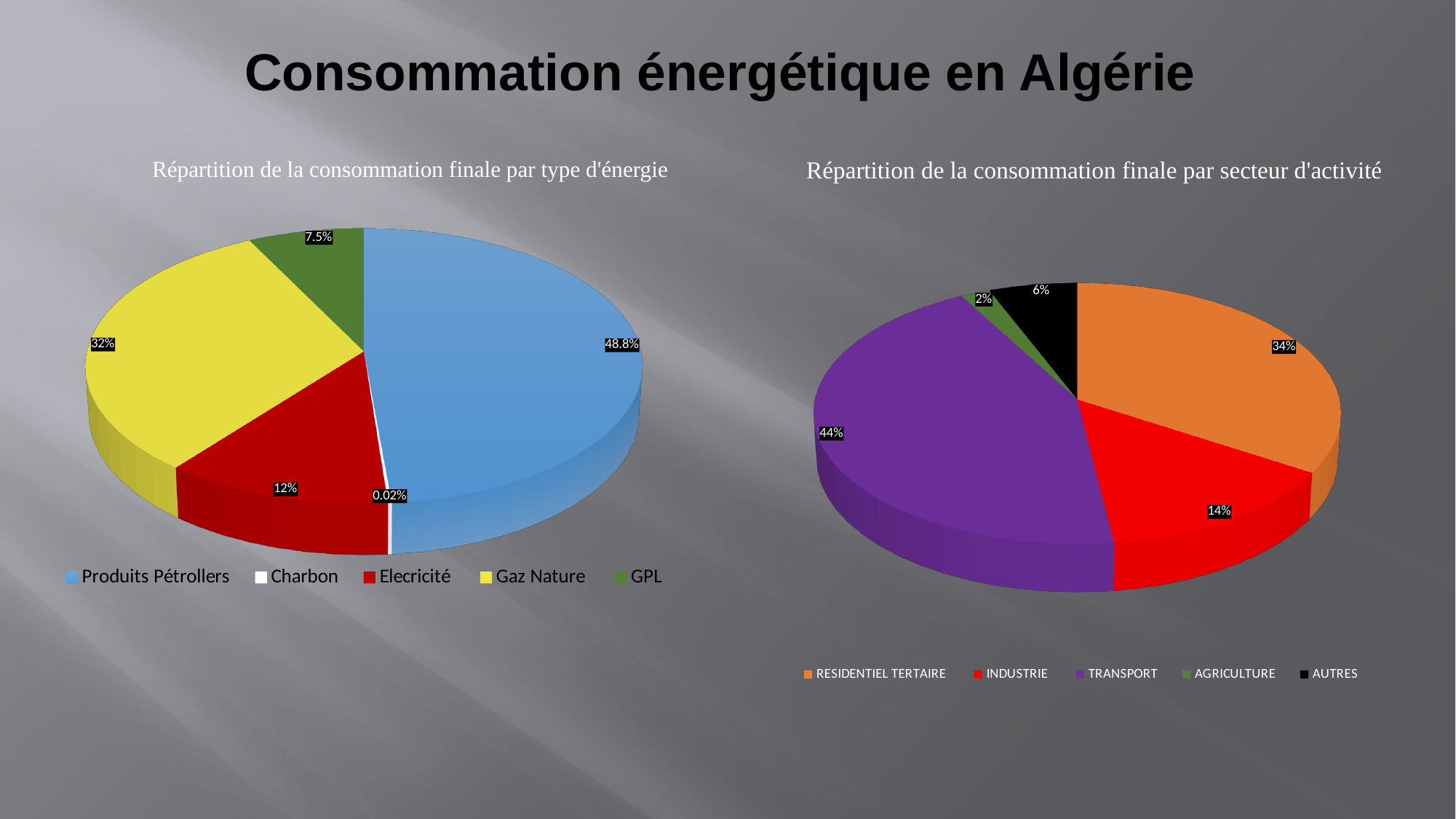
In the left chart 'Répartition de la consommation finale par type d'énergie', what is the share for Charbon? 0.02% In the left chart 'Répartition de la consommation finale par type d'énergie', what is the share for Gaz Nature? 32% In the left chart 'Répartition de la consommation finale par type d'énergie', what is the share for Produits Pétrollers? 48.8% In the right chart 'Répartition de la consommation finale par secteur d'activité', which is larger, RESIDENTIEL TERTAIRE or TRANSPORT? TRANSPORT In the right chart 'Répartition de la consommation finale par secteur d'activité', what is the share for INDUSTRIE? 14% In the left chart 'Répartition de la consommation finale par type d'énergie', which energy type has the largest share? Produits Pétrollers In the left chart 'Répartition de la consommation finale par type d'énergie', what is the difference between the shares of Gaz Nature and Elecricité? 20% In the right chart 'Répartition de la consommation finale par secteur d'activité', which sector has the smallest share? AGRICULTURE In the left chart 'Répartition de la consommation finale par type d'énergie', which energy type has the smallest share? Charbon How many sectors does the legend of the right chart 'Répartition de la consommation finale par secteur d'activité' list? 5 What kind of chart is the left chart 'Répartition de la consommation finale par type d'énergie'? Pie chart In the right chart 'Répartition de la consommation finale par secteur d'activité', what is the share for TRANSPORT? 44%